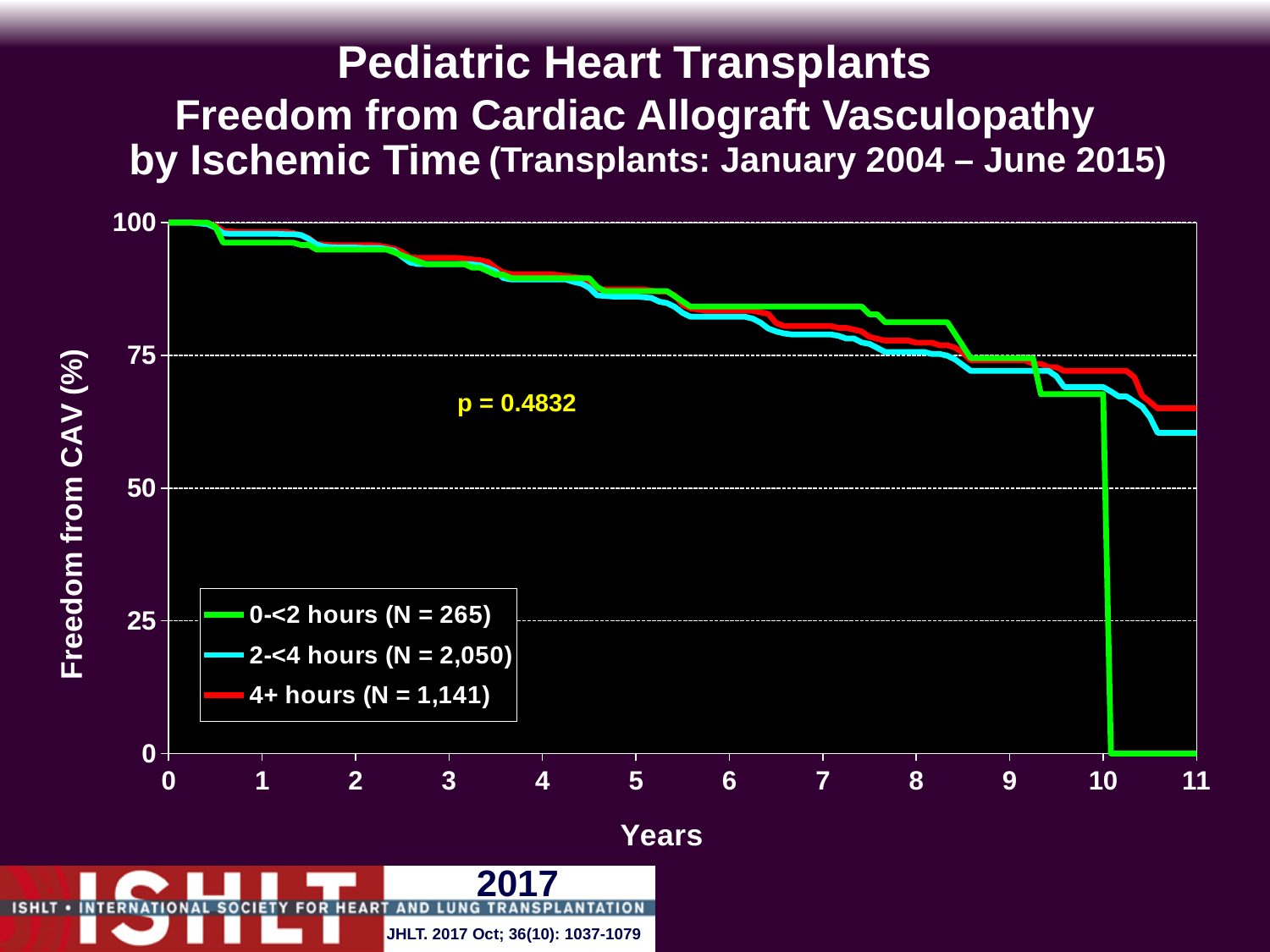
Is the value for the 0-<2 hours group at 10.5 years greater or less than 25? less At 11 years, which is higher: the 4+ hours group or the 2-<4 hours group? 4+ hours How many series does the legend list? 3 Do the freedom from CAV curves rise or fall as years increase? fall Is the value for the 4+ hours group at 5 years greater or less than 75? greater What kind of chart is shown on the slide? line chart Which group has the lowest freedom from CAV at 10.5 years? 0-<2 hours Is the value for the 2-<4 hours group at 2 years greater or less than 75? greater At 8 years, which is higher: the 0-<2 hours group or the 2-<4 hours group? 0-<2 hours What is the p-value printed on the chart? p = 0.4832 According to the legend, what is the N for the 2-<4 hours group? N = 2,050